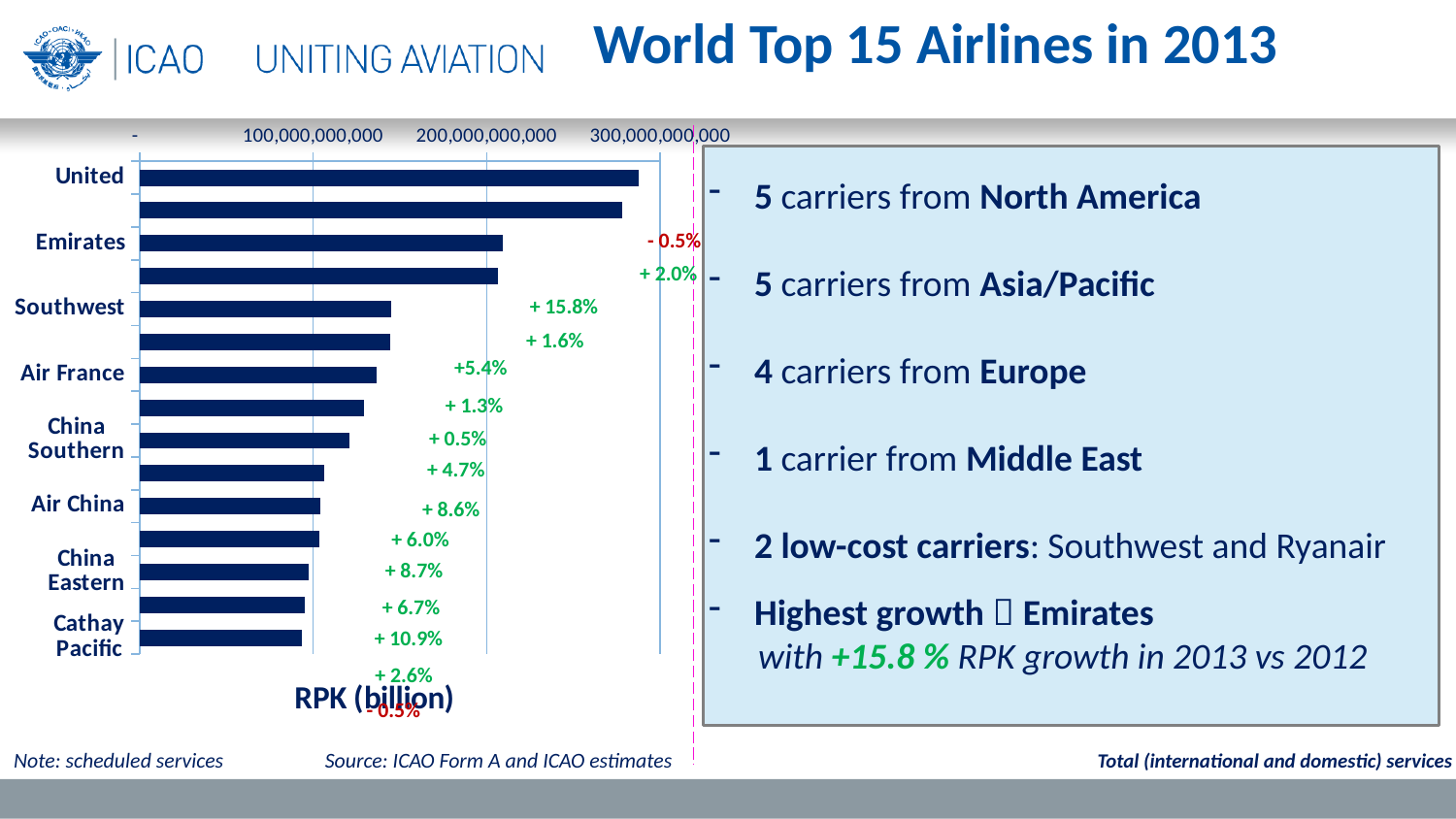
Is the value for China Southern greater or less than 200,000,000,000? less Which airline has the longest bar in the chart? United Is the value for United greater or less than 200,000,000,000? greater Is the value for Air France greater or less than 100,000,000,000? greater Do the bar values rise or fall going from the top of the chart to the bottom? fall What is the title of the slide's chart? World Top 15 Airlines in 2013 Which has the larger value, United or Emirates? United How many bars are plotted in the chart? 15 What kind of chart is shown on the slide? bar chart What label is shown beneath the chart's bars? RPK (billion) Which has the larger value, Southwest or Air France? Southwest